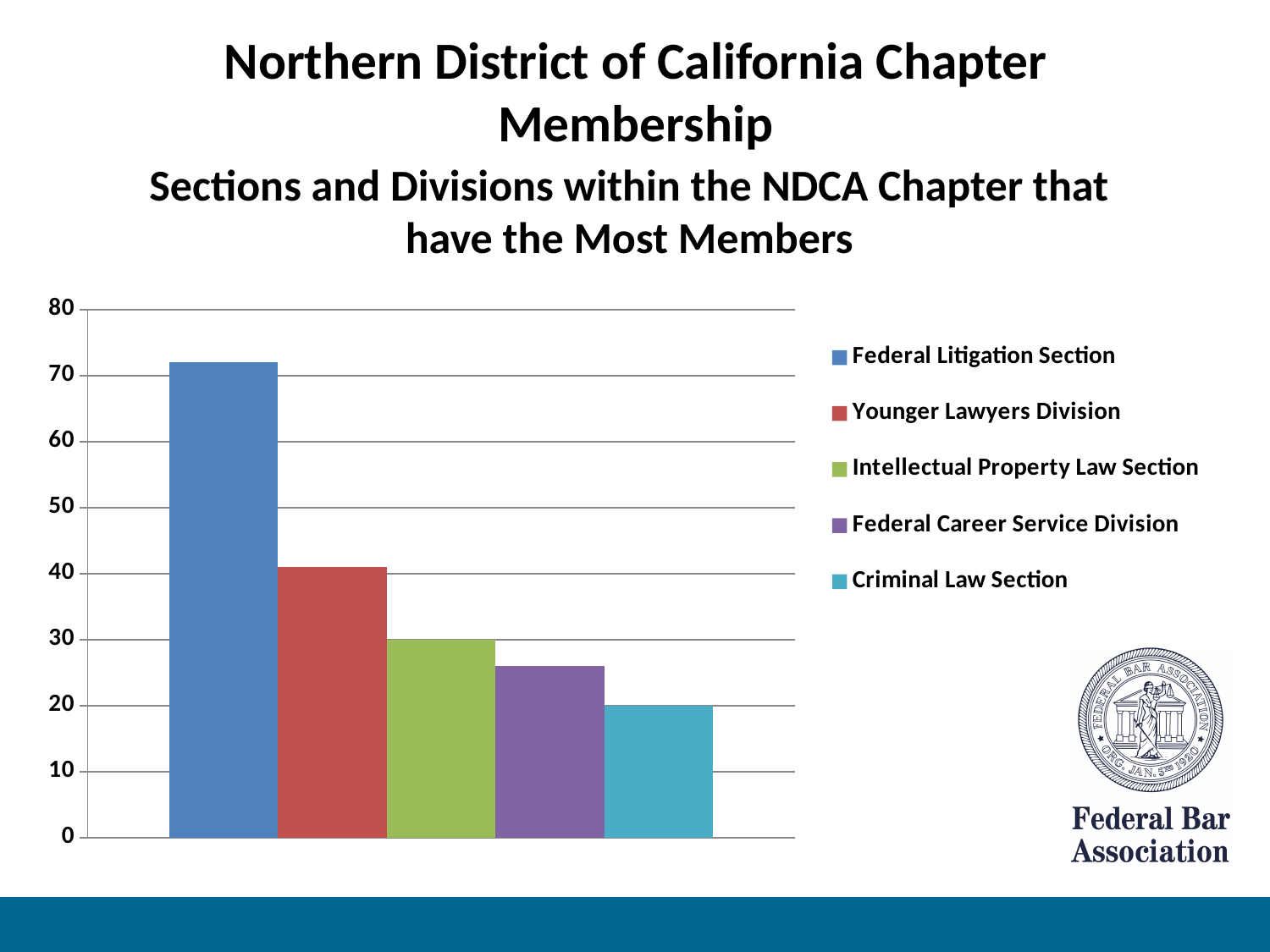
What is the value for Criminal Law Section? 20 How many bars are plotted in the chart? 5 Which section or division has the lowest number of members? Criminal Law Section What is the value for Intellectual Property Law Section? 30 How many series does the legend list? 5 Which section or division has the highest number of members? Federal Litigation Section What colour is the bar for Federal Career Service Division? purple Which is larger, the value for Younger Lawyers Division or the value for Intellectual Property Law Section? Younger Lawyers Division Is the value for Federal Career Service Division greater or less than 30? less Is the value for Federal Litigation Section greater or less than 70? greater What kind of chart is shown on the slide? bar chart